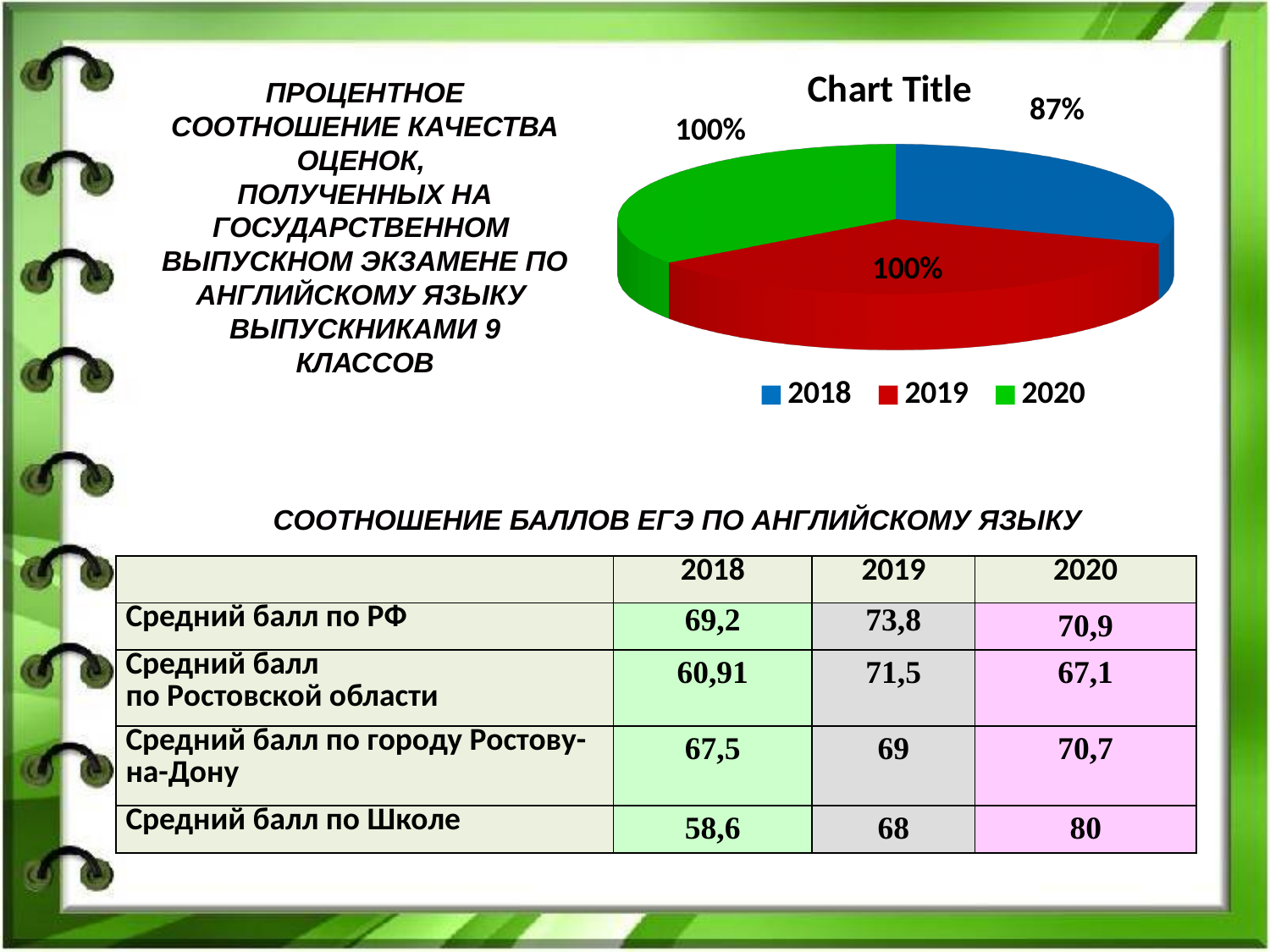
Which is larger in the pie chart, the value for 2018 or the value for 2019? 2019 What colour is the 2019 slice in the pie chart? Red What is the value shown for 2019 in the pie chart? 100% What is the title of the pie chart? Chart Title What is the difference between the value for 2019 and the value for 2018 in the pie chart? 13% How many slices does the pie chart have? 3 What is the value shown for 2018 in the pie chart? 87% How many entries does the legend of the pie chart list? 3 What is the value shown for 2020 in the pie chart? 100% What kind of chart is shown on the slide? Pie chart Which year has the lowest value in the pie chart? 2018